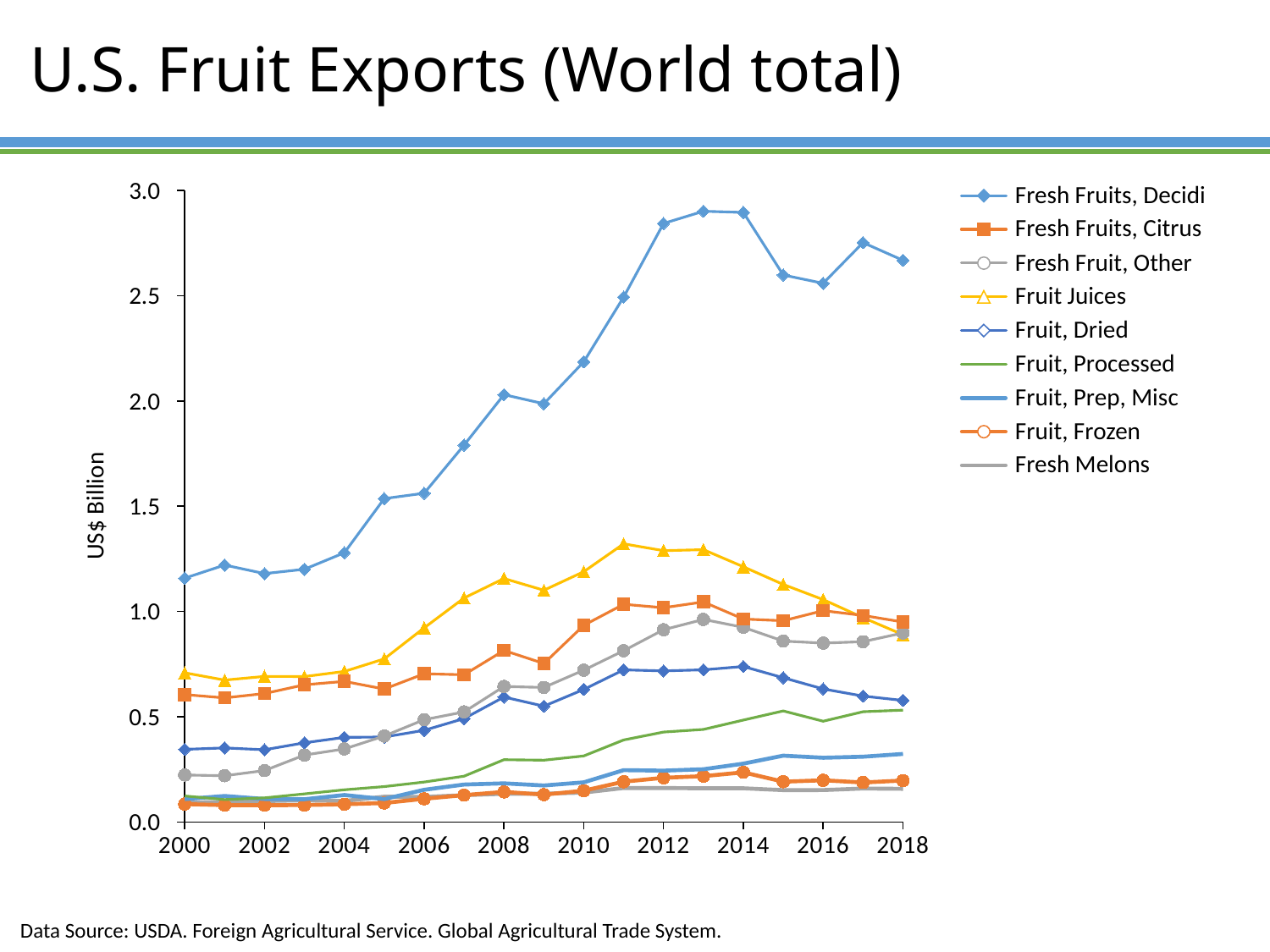
What is the label on the y axis? US$ Billion What kind of chart is shown on the slide? Line chart Does the Fresh Fruits, Decidi series rise or fall from 2000 to 2013? rise Is the value for Fruit Juices in 2011 greater or less than 1.0? greater Which series has the highest value in 2013? Fresh Fruits, Decidi Which series has the highest value in 2018? Fresh Fruits, Decidi How many years are plotted along the x axis, from 2000 to 2018? 19 How many series does the legend list? 9 Is the value for Fruit, Dried in 2018 greater or less than 1.0? less Is the value for Fresh Fruits, Decidi in 2000 greater or less than 1.5? less In 2011, which is larger: Fruit Juices or Fresh Fruits, Citrus? Fruit Juices